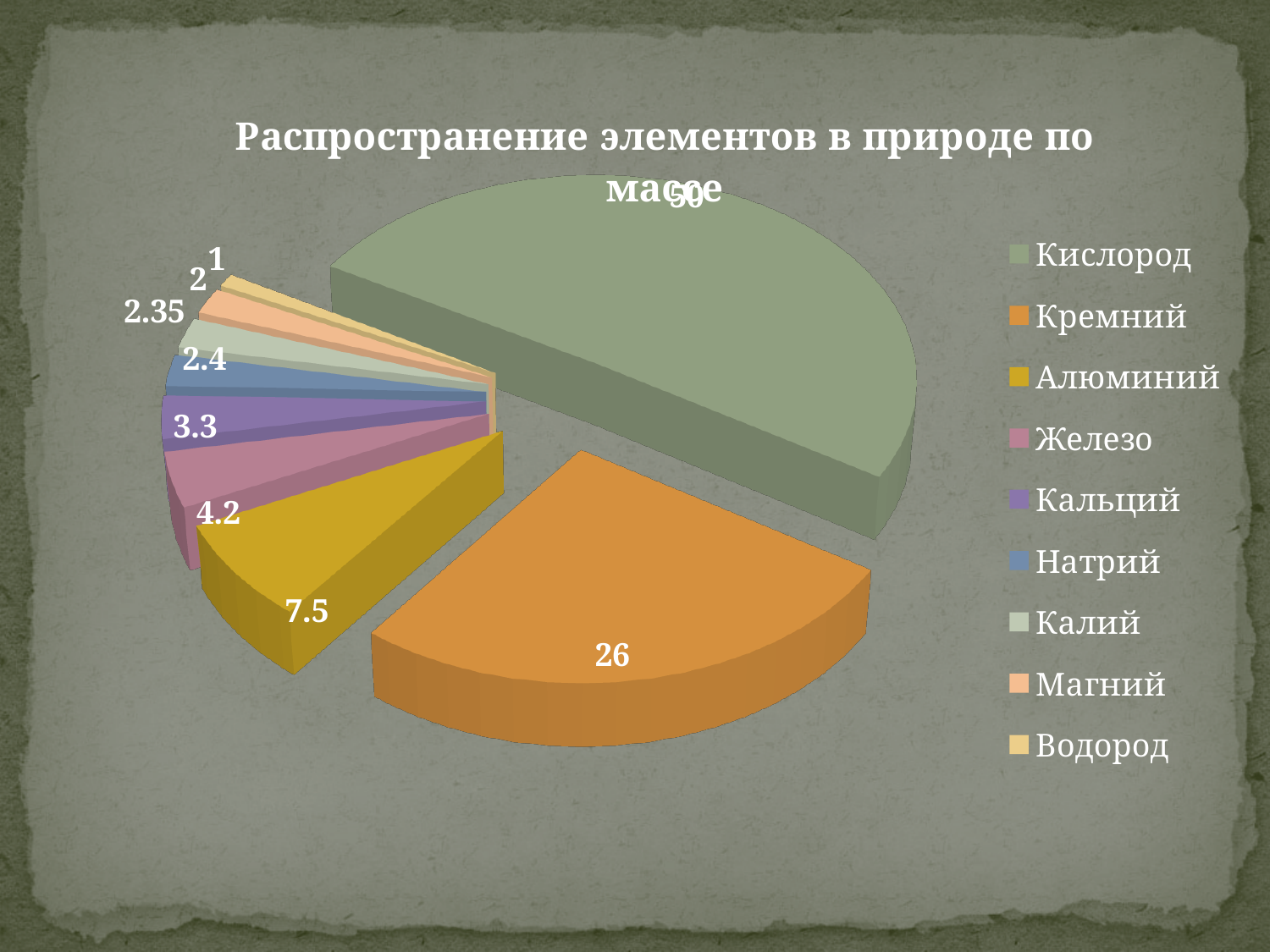
What is the value for Алюминий? 7.5 What is the value for Кальций? 3.3 Which element has the largest slice of the pie? Кислород What is the value for Калий? 2.35 Which element has the smallest slice of the pie? Водород How many categories does the legend list? 9 What type of chart is shown on the slide? pie chart What is the title of the chart? Распространение элементов в природе по массе What is the value for Железо? 4.2 What is the value for Кремний? 26 What is the difference between the values for Кремний and Алюминий? 18.5 What is the value for Водород? 1